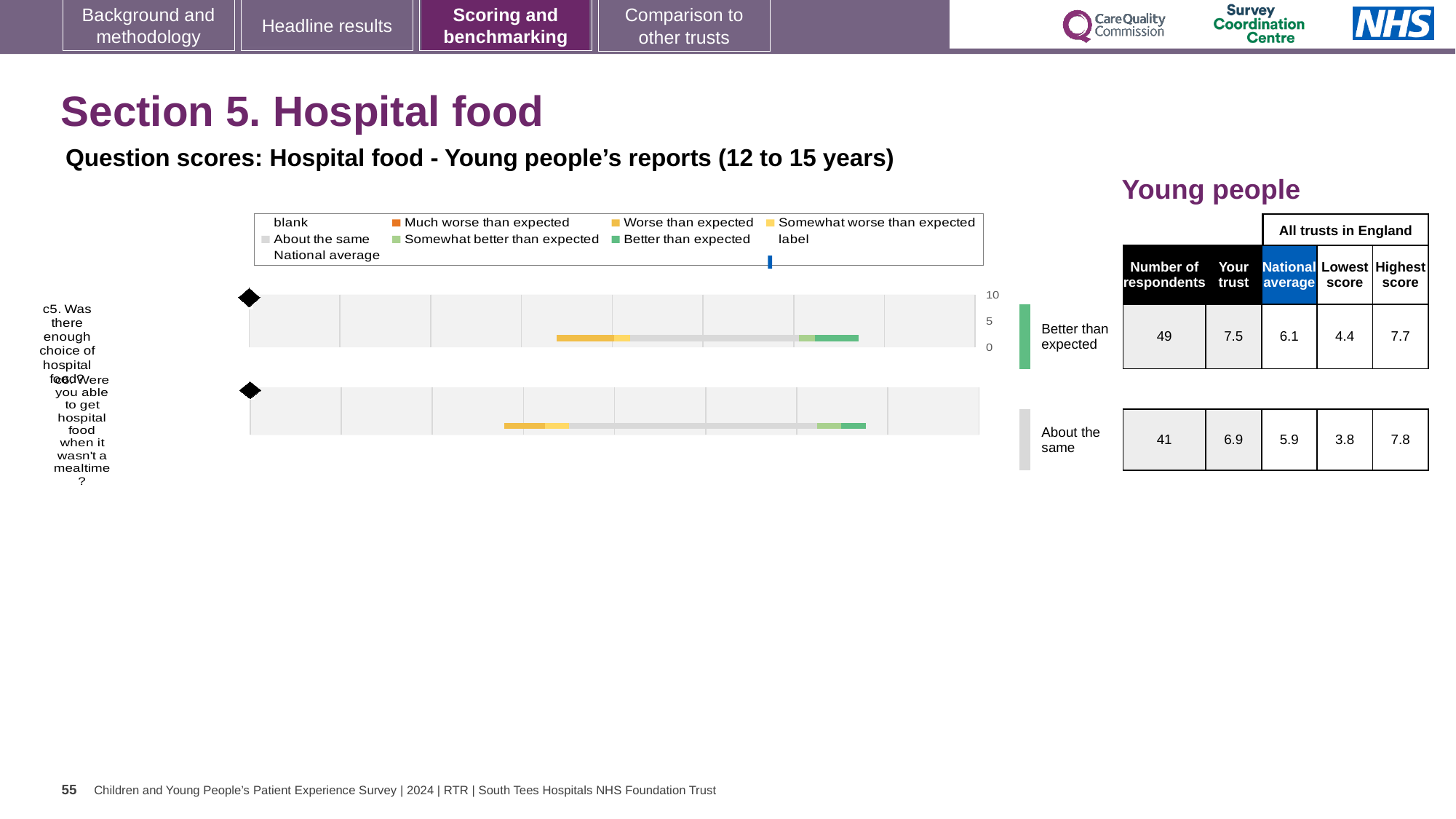
How many respondents answered question c5? 49 What is the 'Your trust' score for question c6 (Were you able to get hospital food when it wasn't a mealtime?)? 6.9 What is the 'Your trust' score for question c5 (Was there enough choice of hospital food?)? 7.5 What is the national average score for question c6? 5.9 How many questions (bars) are plotted in the chart? 2 What is the highest score across all trusts in England for question c6? 7.8 What colour does the legend use for 'Better than expected'? green What is the highest tick value shown on the chart's axis? 10 Which benchmark category is question c5 rated as? Better than expected Which question has the higher 'Your trust' score, c5 or c6? c5 What is the difference between the 'Your trust' score and the national average for question c5? 1.4 What kind of chart is shown on the slide? bar chart